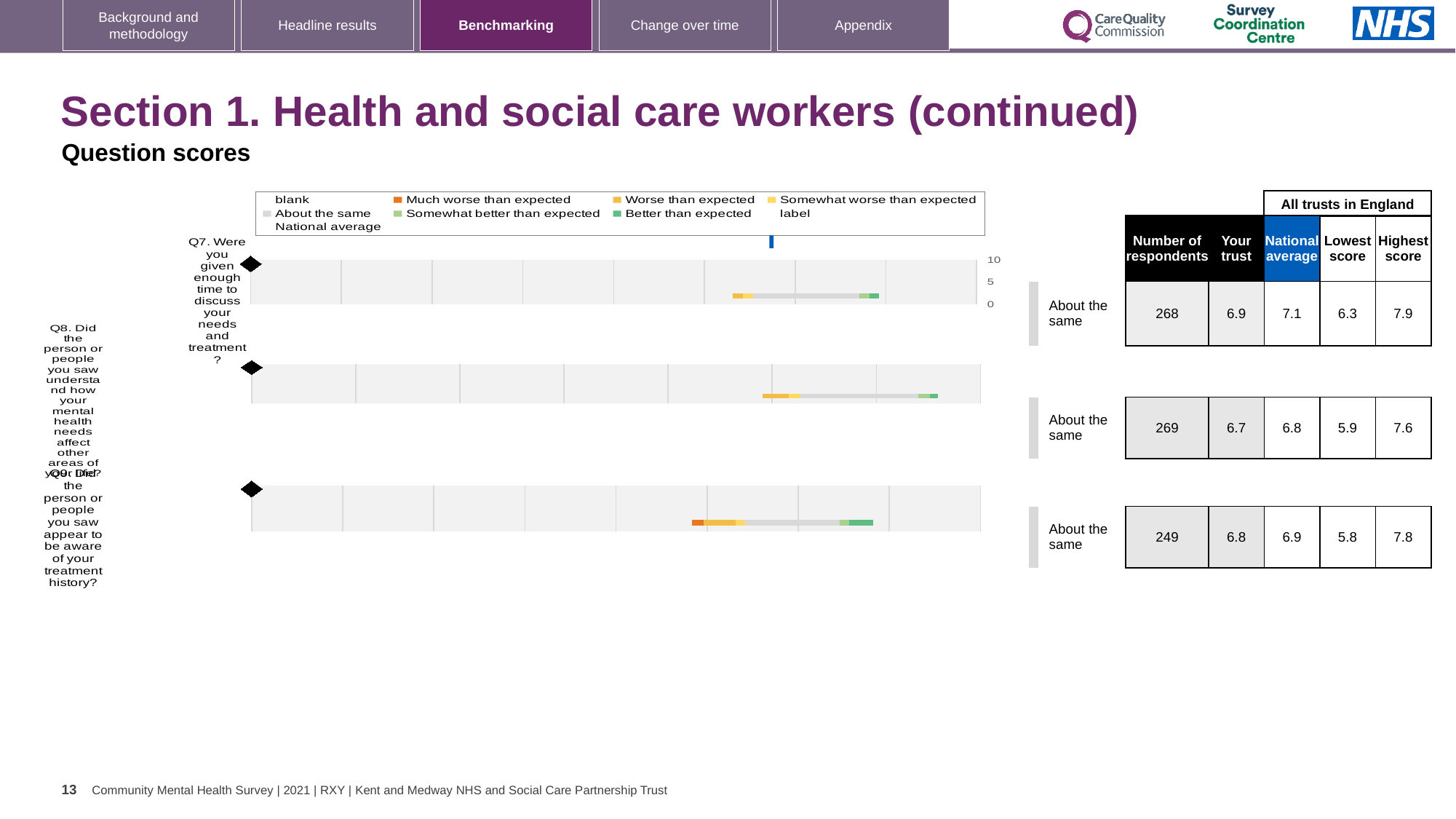
For Q7, what is the difference between the highest score (7.9) and the lowest score (6.3) across all trusts in England? 1.6 For Q8, which is larger: the 'Your trust' score or the national average? National average What kind of chart is used to show the question scores on this slide? bar chart What is the national average score for Q8 (understanding how mental health needs affect other areas of life)? 6.8 Which question has the highest 'Your trust' score on this slide? Q7 How many questions (Q7, Q8, Q9) are charted on this slide? 3 For Q7 (time to discuss needs and treatment), how many respondents are shown in the table? 268 What is the 'Your trust' score for Q7? 6.9 What benchmark category is shown for Q9 next to its chart? About the same In the legend, what colour represents 'Much worse than expected'? Orange What is the lowest score among all trusts in England for Q9 (awareness of treatment history)? 5.8 What is the highest score among all trusts in England for Q9? 7.8